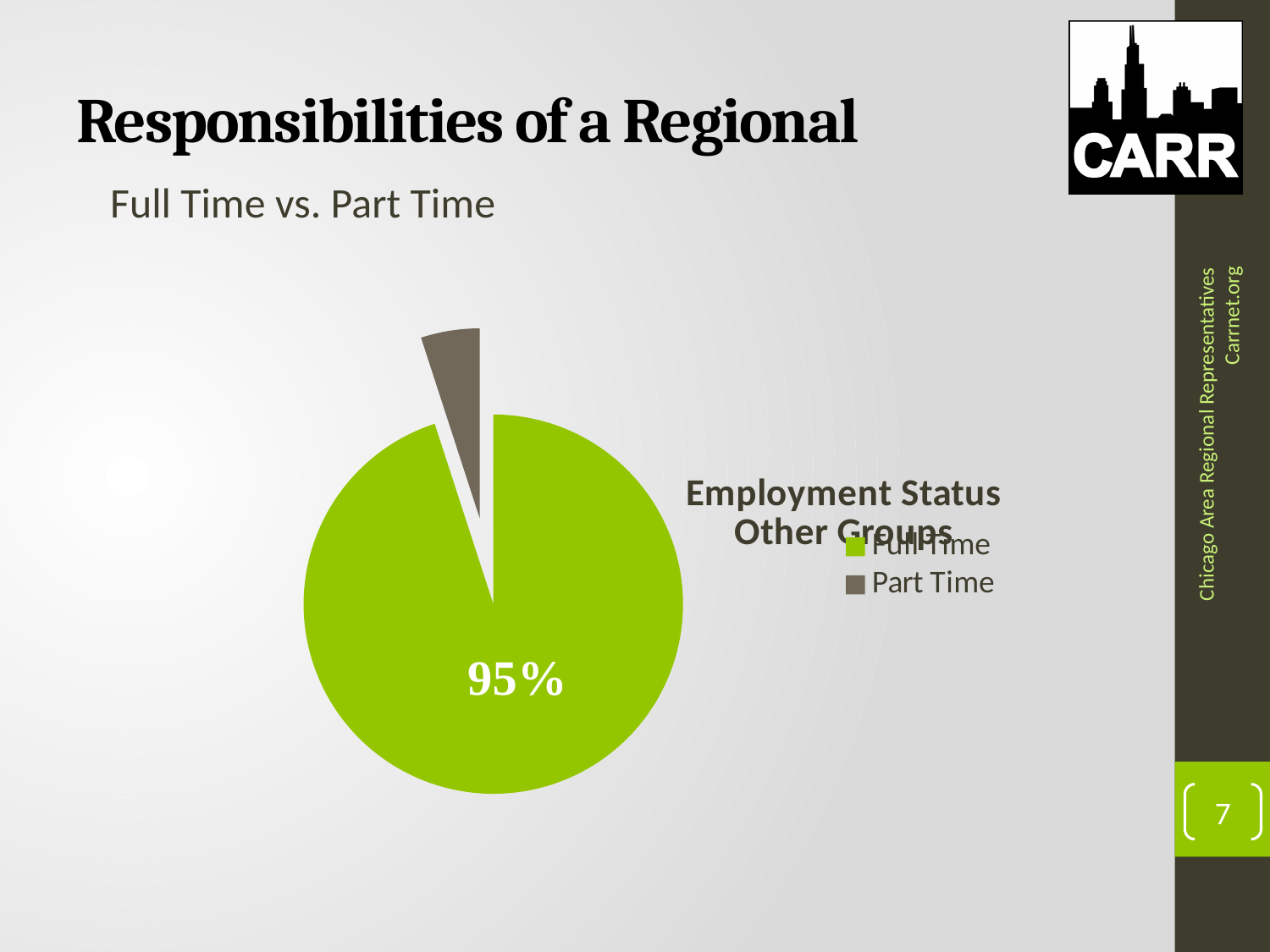
Which slice of the pie chart is the largest? Full Time What is the title of the chart? Employment Status Other Groups How many entries does the chart legend list? 2 What kind of chart is shown on the slide? Pie chart What percentage of the pie chart is labelled for Full Time? 95% How many slices does the pie chart have? 2 Which slice of the pie chart is the smallest? Part Time What colour is the Full Time slice in the pie chart? Green What share of the pie does the Full Time slice represent? 95% Which is larger in the pie chart, Full Time or Part Time? Full Time